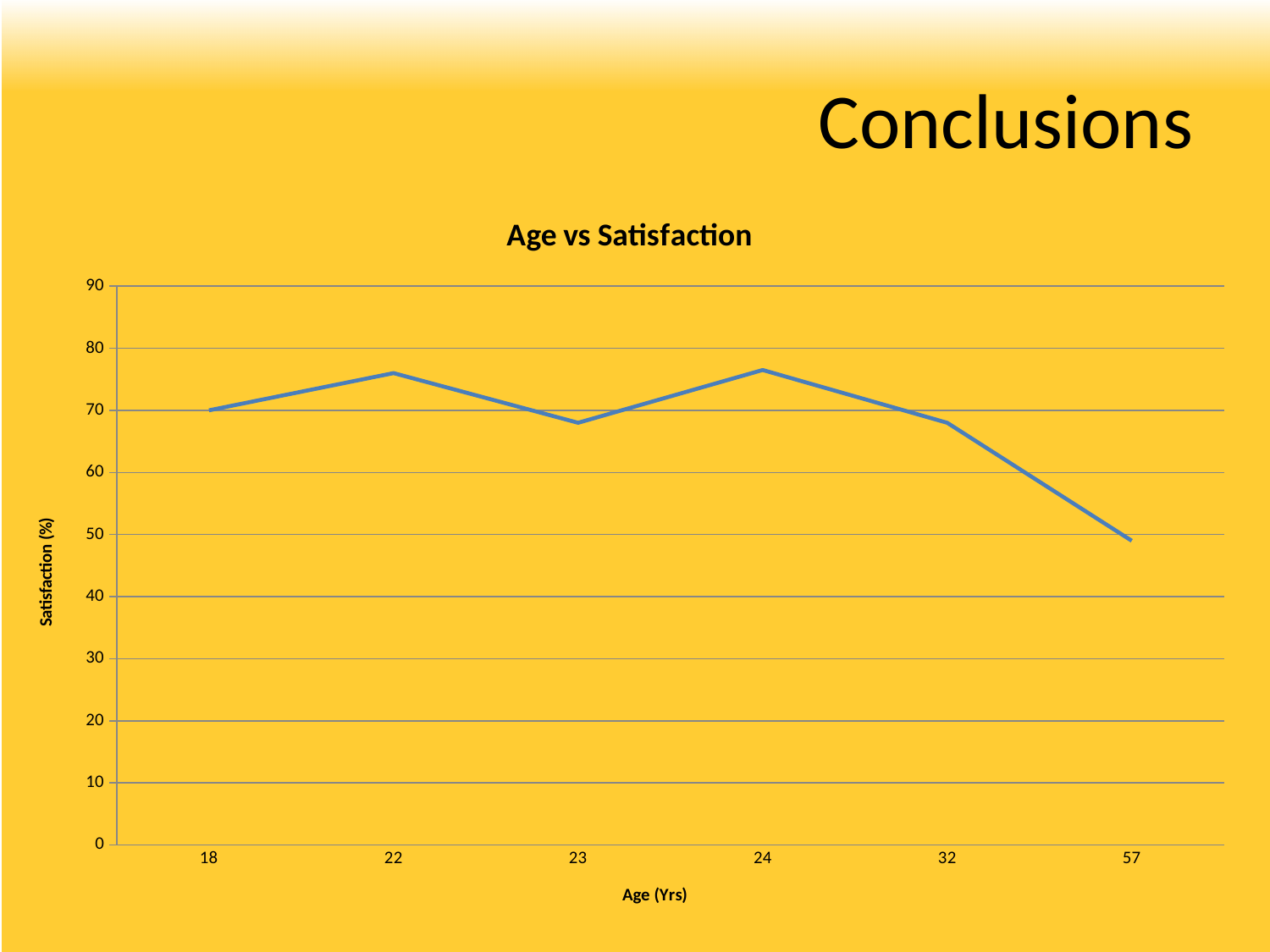
Is the satisfaction value for age 24 greater or less than 80? less Does satisfaction rise or fall from age 24 to age 57? fall Is the satisfaction value for age 22 greater or less than 70? greater What is the title of the chart? Age vs Satisfaction Which has the higher satisfaction, age 24 or age 32? 24 Which age has the lowest satisfaction? 57 Is the satisfaction value for age 18 greater or less than 60? greater How many age points are plotted on the x axis? 6 What is the label of the vertical axis? Satisfaction (%) Which has the higher satisfaction, age 22 or age 23? 22 What kind of chart is shown on the slide? line chart